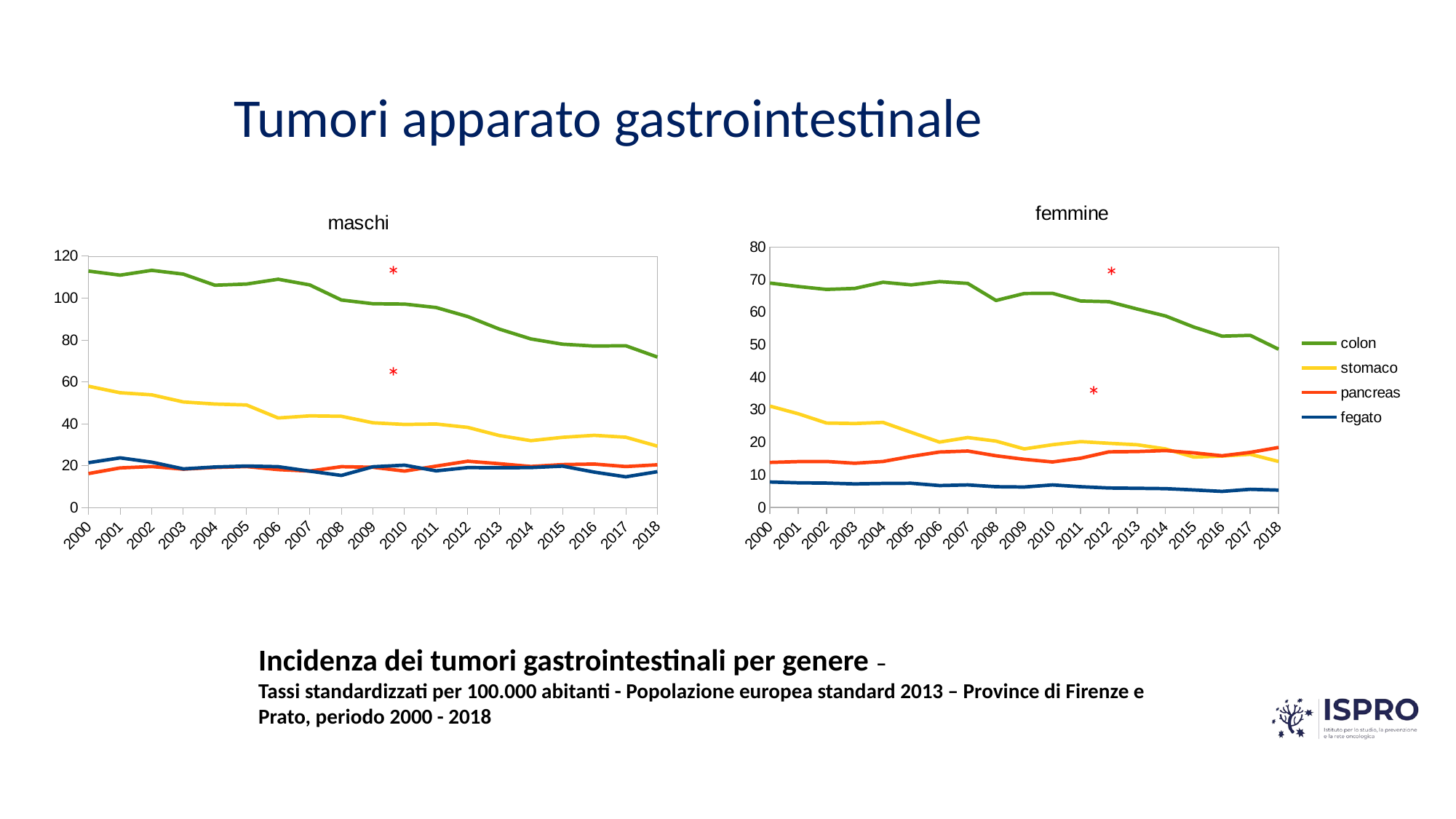
In the 'femmine' chart, is the value for fegato in 2018 greater or less than 10? less In the 'maschi' chart, does the colon series rise or fall from 2000 to 2018? fall In the 'maschi' chart, which series has the highest values across all years? colon How many series does the legend list? 4 In the 'maschi' chart, is the value for stomaco in 2018 greater or less than 40? less In the 'femmine' chart, which series has the lowest values across all years? fegato In the 'femmine' chart, does the stomaco series rise or fall from 2000 to 2018? fall In the 'femmine' chart, which is larger in 2018, pancreas or stomaco? pancreas How many years are plotted on the x axis of the 'femmine' chart? 19 In the 'femmine' chart, is the value for colon in 2000 greater or less than 60? greater What kind of chart is the 'maschi' chart? line chart